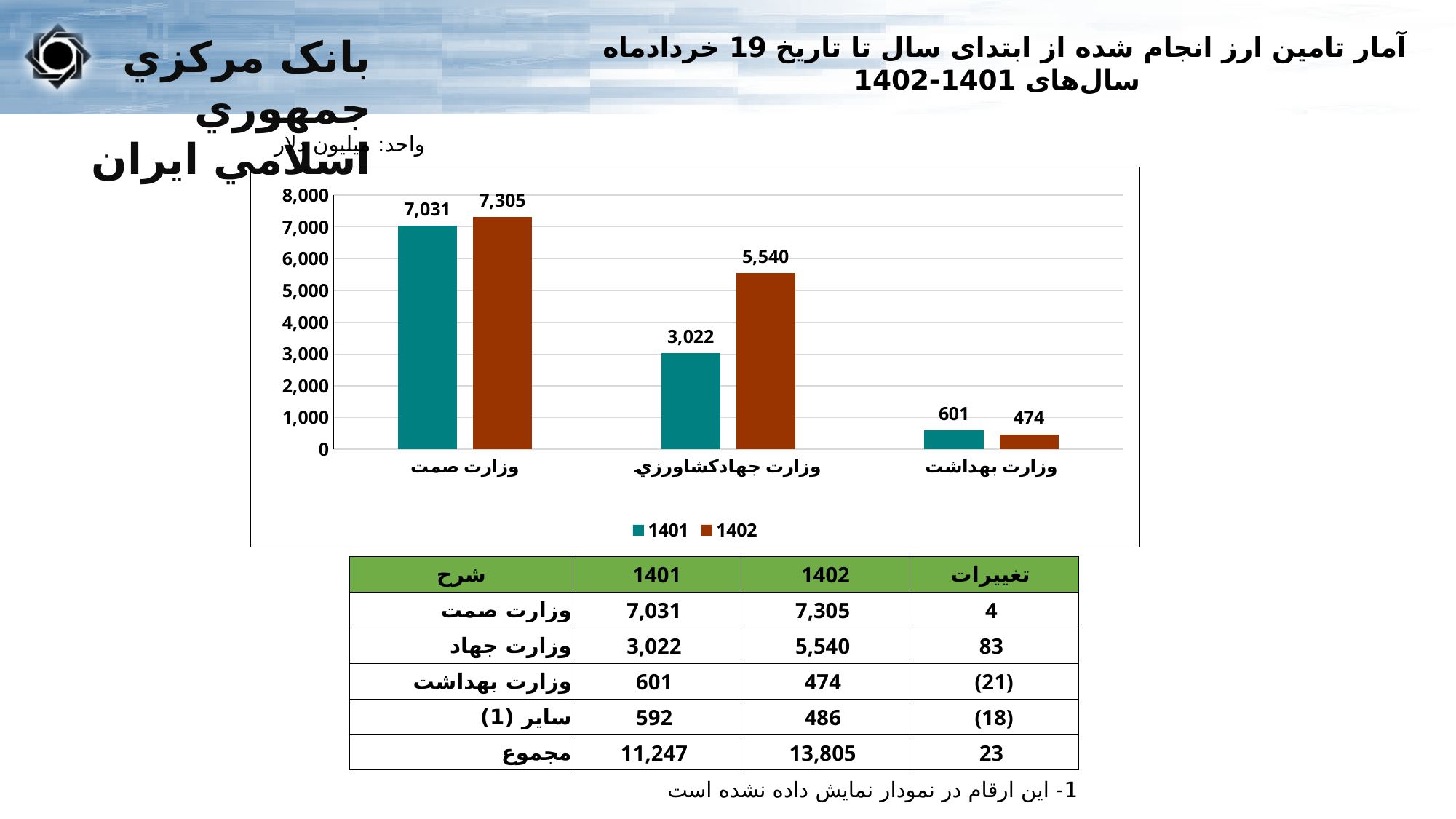
Which category has the highest value in the 1402 series? وزارت صمت Which category has the lowest value in the 1401 series? وزارت بهداشت How many categories are shown on the x axis of the chart? 3 For وزارت بهداشت, which series has the larger value, 1401 or 1402? 1401 Which colour represents the 1402 series in the chart? orange-brown What kind of chart is shown on the slide? bar chart What is the value for وزارت بهداشت in the 1402 series? 474 What is the value for وزارت جهادکشاورزي in the 1402 series? 5,540 Is the 1401 value for وزارت جهادکشاورزي greater or less than 4,000? less What is the difference between the 1402 and 1401 values for وزارت جهادکشاورزي? 2,518 What is the value for وزارت صمت in the 1401 series? 7,031 How many series does the chart legend list? 2